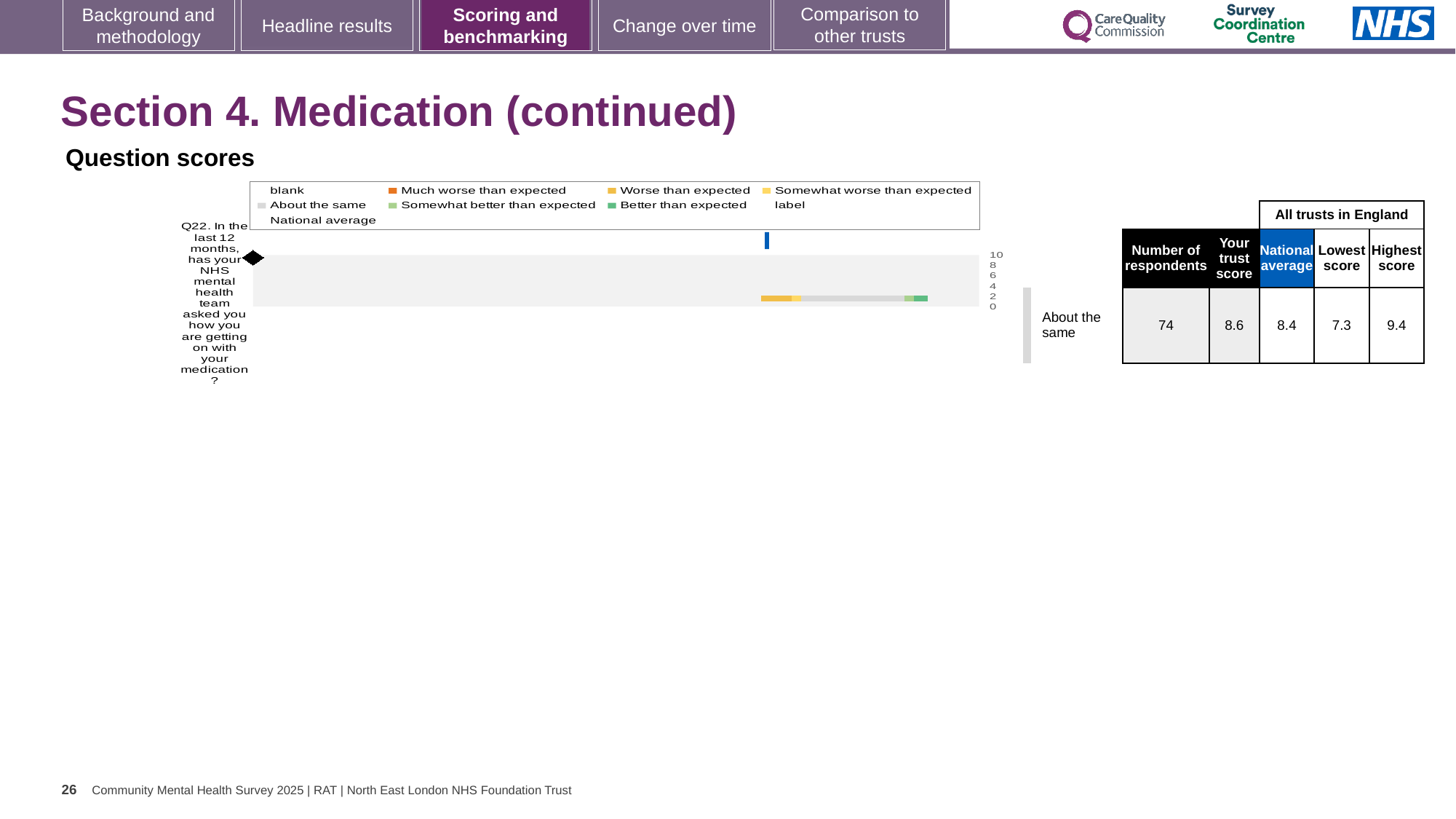
What is the lowest score among all trusts in England for Q22? 7.3 How is the trust's Q22 score categorised relative to expectations? About the same What is the highest score among all trusts in England for Q22? 9.4 What is the trust's score for Q22? 8.6 What is the national average score for Q22? 8.4 Is the trust's score for Q22 higher or lower than the national average? higher Which question is plotted in the Question scores chart? Q22. In the last 12 months, has your NHS mental health team asked you how you are getting on with your medication? What is the difference between the trust's score and the national average for Q22? 0.2 What type of chart is shown under 'Question scores'? bar chart How many questions are plotted in the Question scores chart? 1 What is the number of respondents for Q22? 74 What is the difference between the highest and lowest scores among all trusts in England for Q22? 2.1